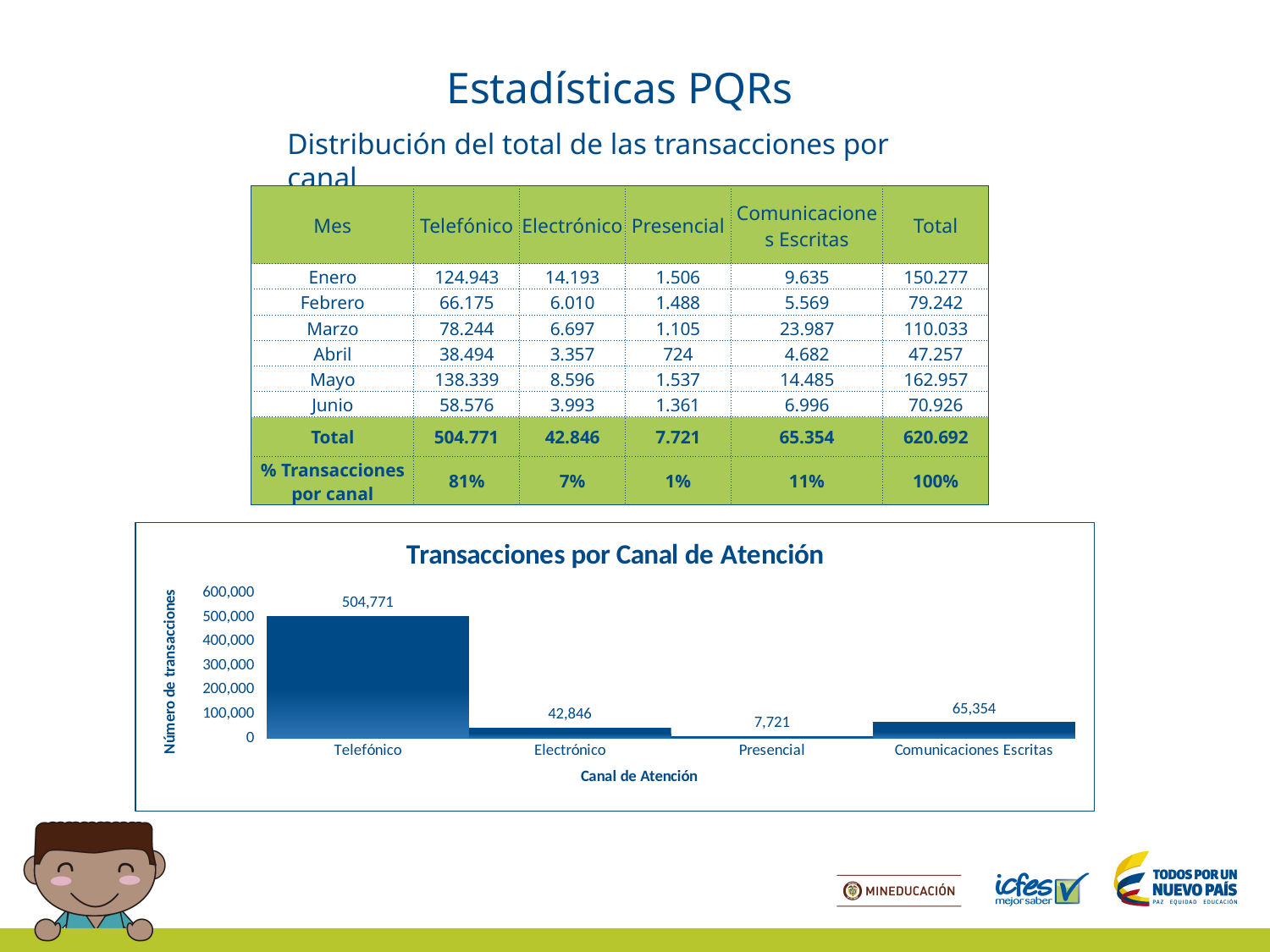
Which channel has the lowest number of transactions in the chart? Presencial What is the title of the chart? Transacciones por Canal de Atención What kind of chart is shown on the slide? Bar chart What is the value for Telefónico in the chart? 504,771 What is the value for Presencial in the chart? 7,721 Which channel has the highest number of transactions in the chart? Telefónico What is the value for Comunicaciones Escritas in the chart? 65,354 What is the difference between the values for Comunicaciones Escritas and Electrónico? 22,508 Is the value for Telefónico greater or less than 500,000? greater Which is larger, the value for Electrónico or the value for Comunicaciones Escritas? Comunicaciones Escritas How many channels are shown on the x axis of the chart? 4 What is the value for Electrónico in the chart? 42,846